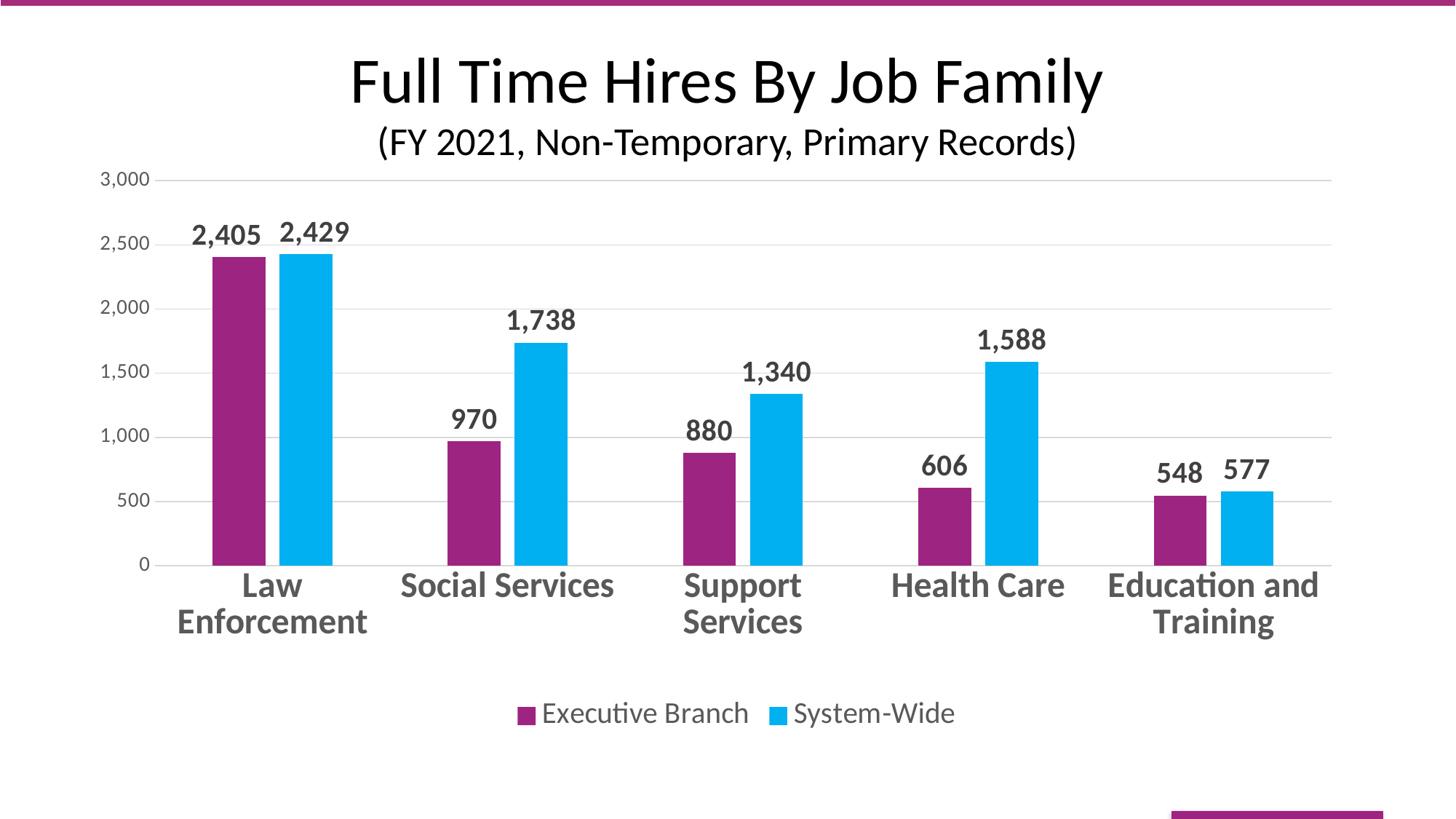
What is the System-Wide value for Social Services? 1,738 How many series does the legend list? 2 Is the System-Wide value for Support Services greater or less than 1,000? greater What is the title of the chart? Full Time Hires By Job Family Which is larger, the Executive Branch value for Social Services or the Executive Branch value for Support Services? Social Services Which job family has the lowest Executive Branch value? Education and Training What kind of chart is shown on the slide? bar chart What is the difference between the System-Wide and Executive Branch values for Health Care? 982 What is the Executive Branch value for Health Care? 606 How many job families are shown on the x axis? 5 Which job family has the highest System-Wide value? Law Enforcement What is the Executive Branch value for Law Enforcement? 2,405